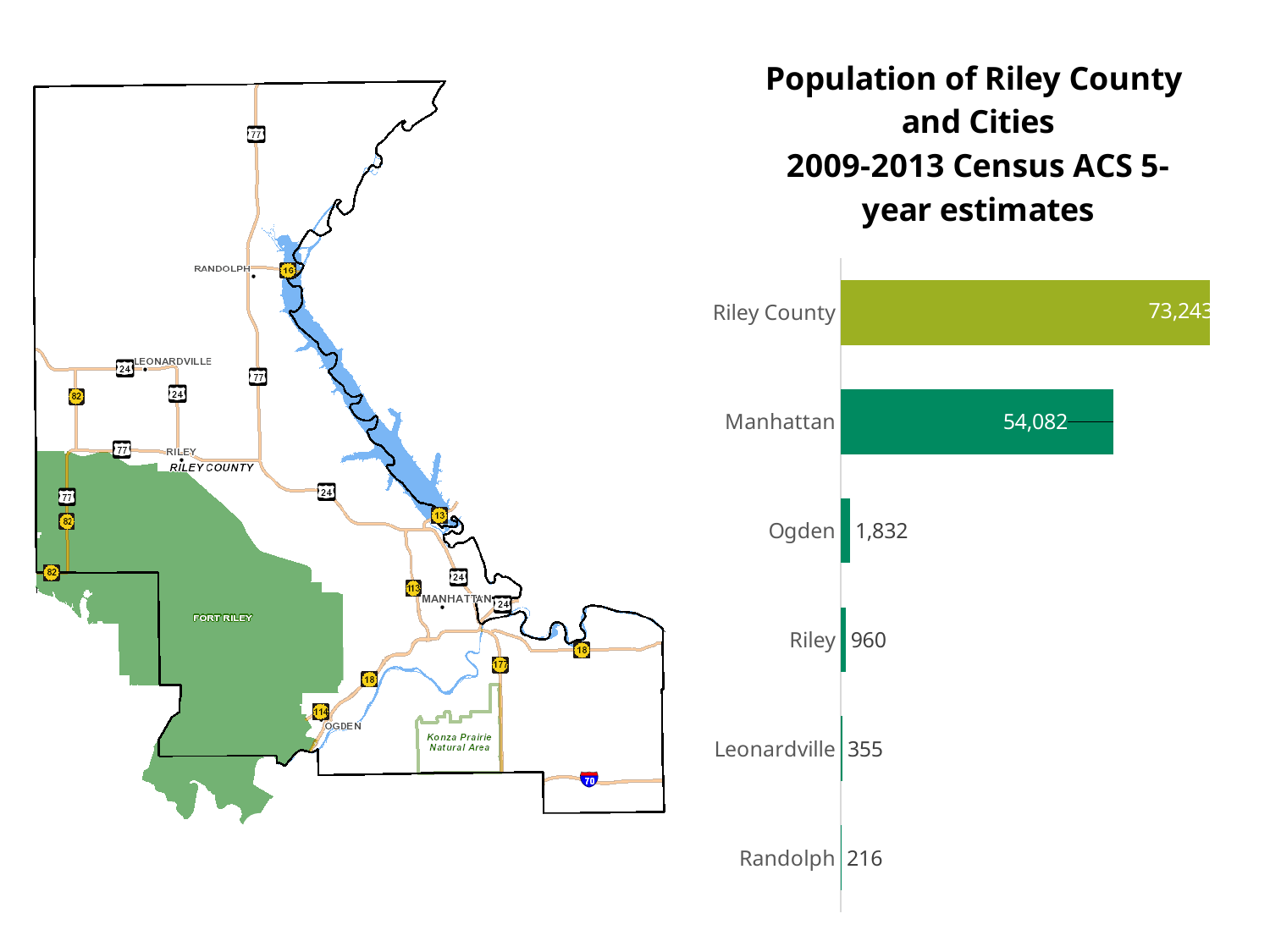
What is the difference between the population of Ogden and the population of Riley? 872 What is the population shown for Manhattan? 54,082 What is the population shown for Randolph? 216 Which category has the highest population value on the chart? Riley County What kind of chart is shown on the slide? Bar chart What is the difference between the population of Riley County and the population of Manhattan? 19,161 How many categories are shown on the chart? 6 Which category has the lowest population value on the chart? Randolph Which has a larger population, Leonardville or Randolph? Leonardville What is the population shown for Ogden? 1,832 What is the population shown for Leonardville? 355 What is the title of the chart? Population of Riley County and Cities 2009-2013 Census ACS 5-year estimates